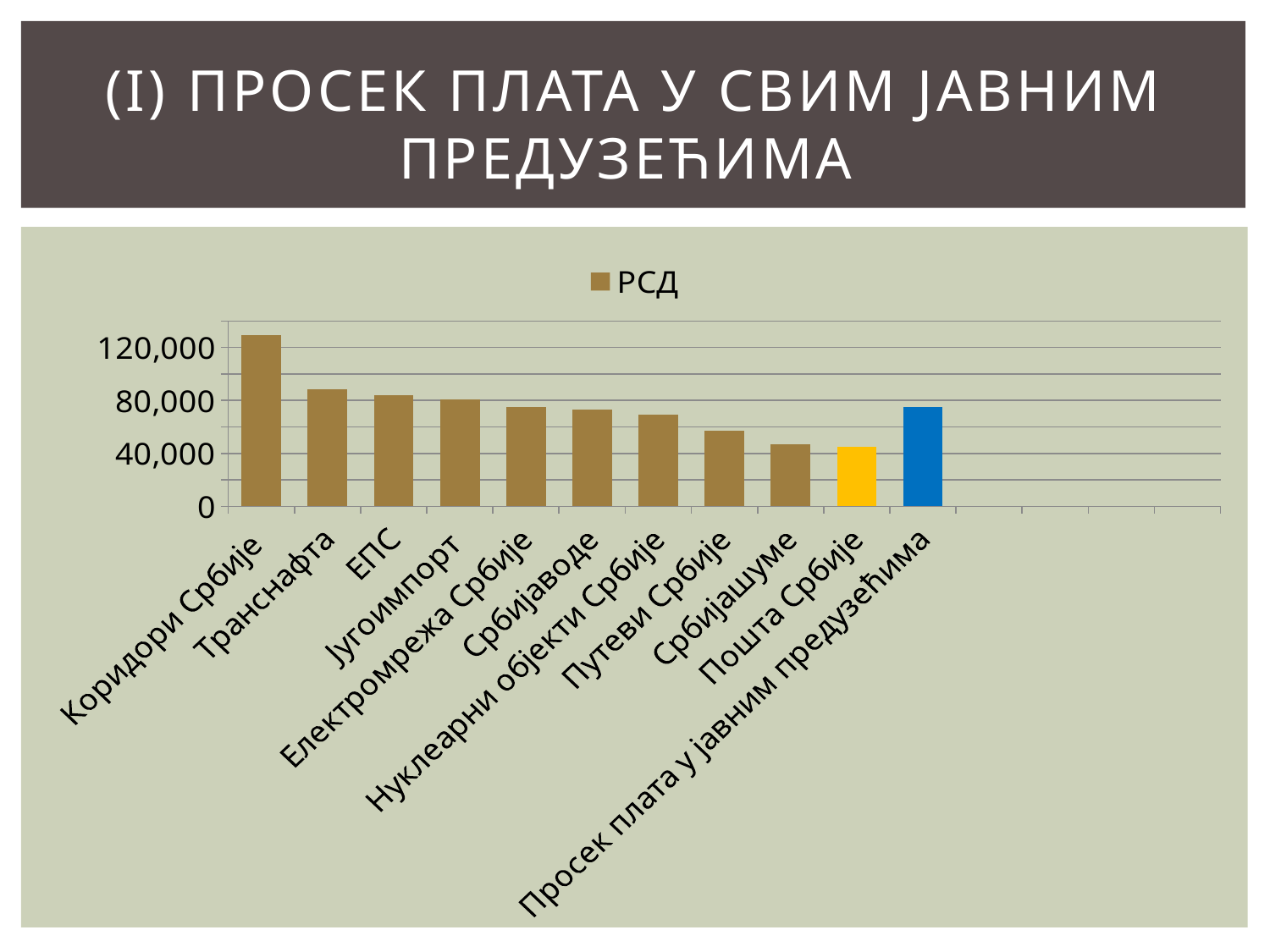
Which is larger, the value for Коридори Србије or the value for Транснафта? Коридори Србије Is the value for Пошта Србије greater or less than 80,000? less How many categories are plotted on the x axis? 11 Is the value for Коридори Србије greater or less than 120,000? greater What is the name of the series shown in the legend? РСД How many series does the legend list? 1 Is the value for Путеви Србије greater or less than 40,000? greater Which is larger, the value for Југоимпорт or the value for Пошта Србије? Југоимпорт Do the values rise or fall from Коридори Србије to Пошта Србије along the x axis? fall What kind of chart is shown on the slide? bar chart Which category has the highest value? Коридори Србије